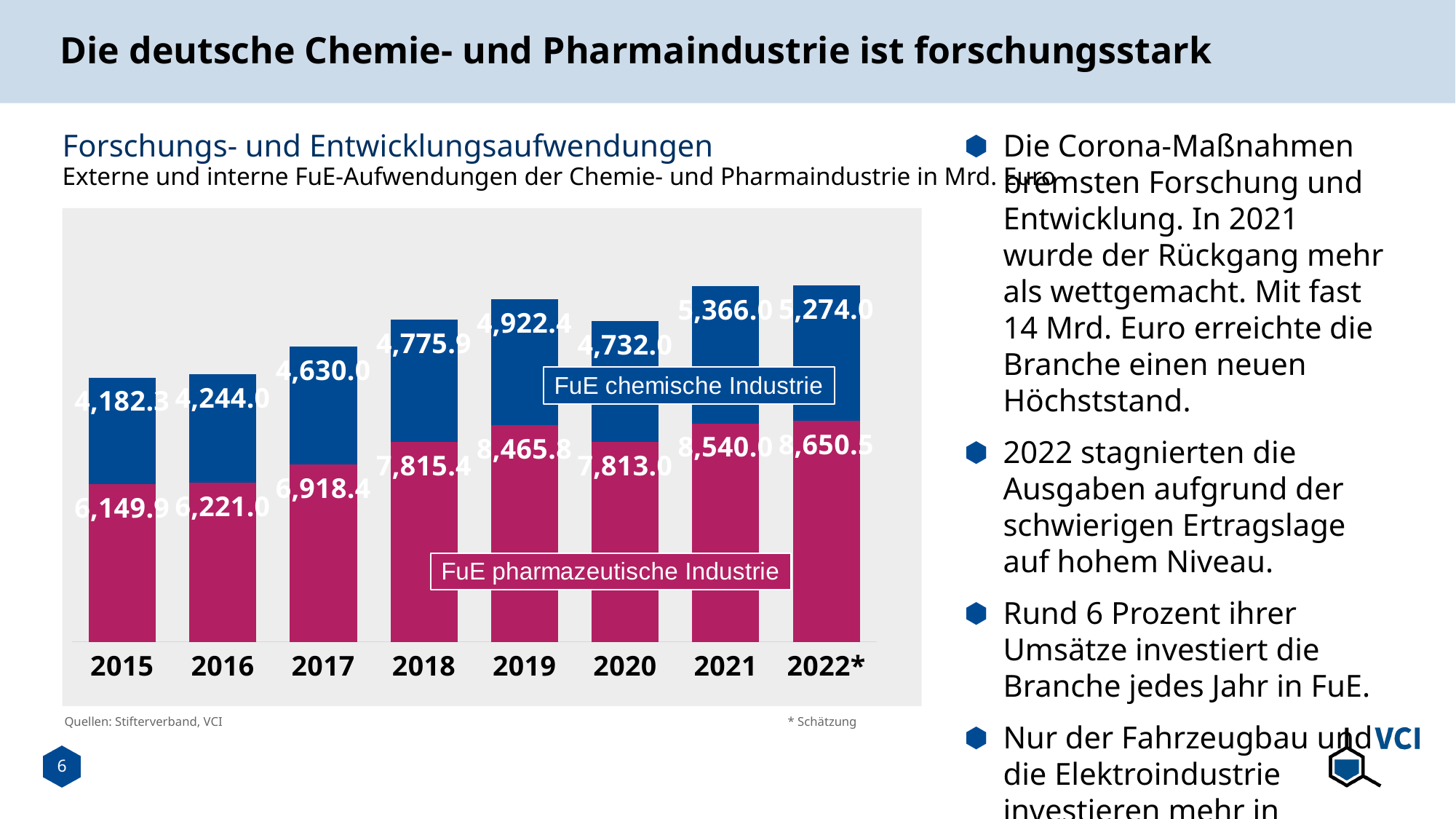
What is the value for FuE pharmazeutische Industrie in 2019? 8,465.8 What is the value for FuE chemische Industrie in 2017? 4,630.0 In which year is the value for FuE pharmazeutische Industrie lowest? 2015 What is the difference between the FuE chemische Industrie values for 2021 and 2020? 634.0 Which is larger, the FuE pharmazeutische Industrie value for 2019 or for 2020? 2019 How many years are shown on the x axis of the chart? 8 What is the total of the stacked bar for 2021? 13,906.0 What is the value for FuE pharmazeutische Industrie in 2022*? 8,650.5 Does the value for FuE pharmazeutische Industrie rise or fall from 2015 to 2019? Rise How many data series does the chart show? 2 What type of chart is shown on the slide? Stacked bar chart In which year is the value for FuE chemische Industrie highest? 2021